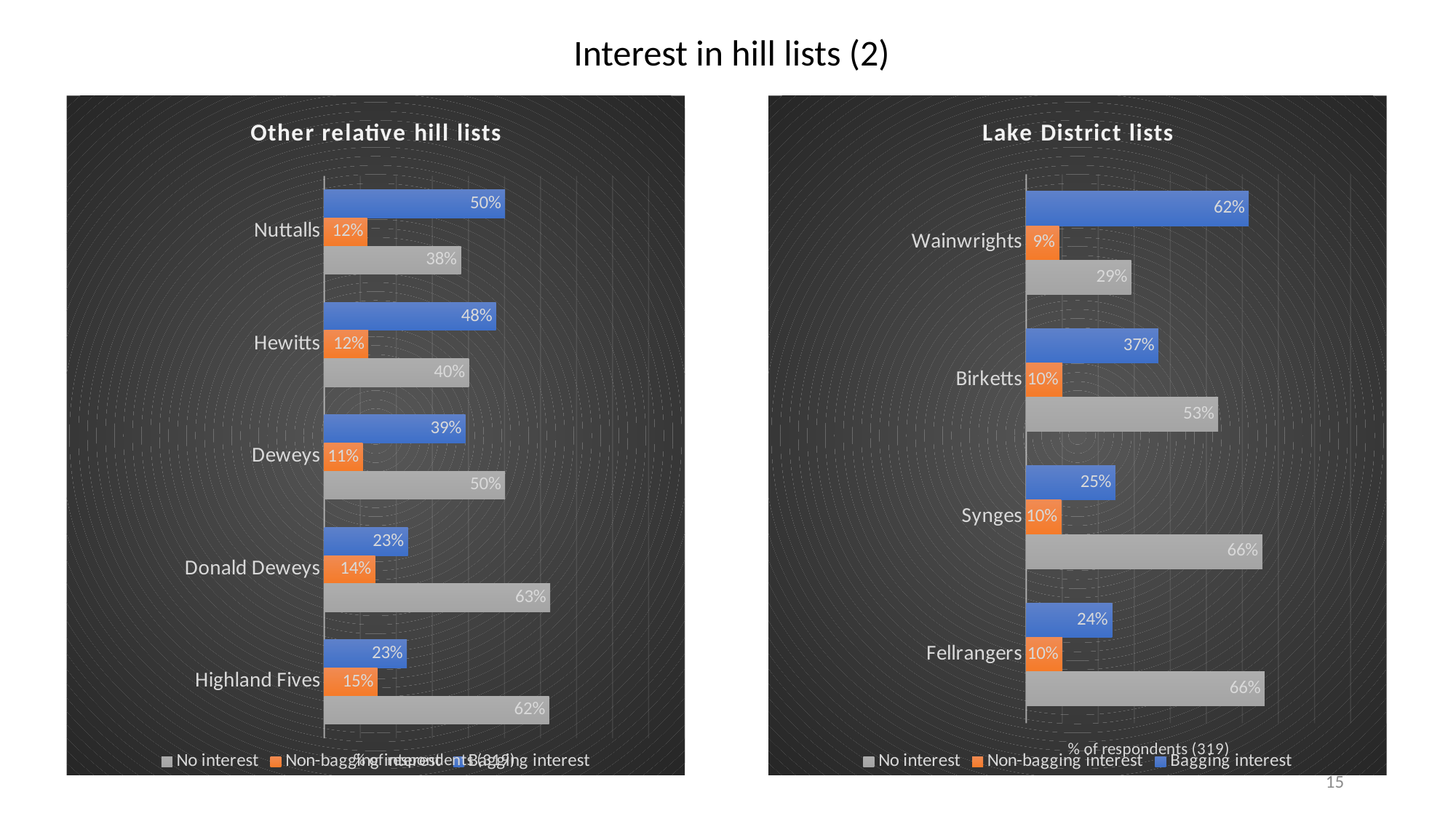
In the 'Lake District lists' chart, what is the difference between the No interest values for Synges and Wainwrights? 37% What type of chart is the 'Other relative hill lists' chart? Bar chart In the 'Other relative hill lists' chart, what is the Bagging interest value for Nuttalls? 50% In the 'Other relative hill lists' chart, what is the No interest value for Donald Deweys? 63% In the 'Other relative hill lists' chart, what is the difference between the No interest and Bagging interest values for Deweys? 11% How many series does the legend of the 'Lake District lists' chart list? 3 In the 'Lake District lists' chart, which hill list has the lowest Bagging interest value? Fellrangers In the 'Lake District lists' chart, what is the Non-bagging interest value for Wainwrights? 9% In the 'Lake District lists' chart, what is the Bagging interest value for Wainwrights? 62% In the 'Other relative hill lists' chart, which hill list has the highest Non-bagging interest value? Highland Fives In the 'Lake District lists' chart, is the No interest value larger for Birketts or for Synges? Synges In the 'Other relative hill lists' chart, how many hill lists are shown? 5